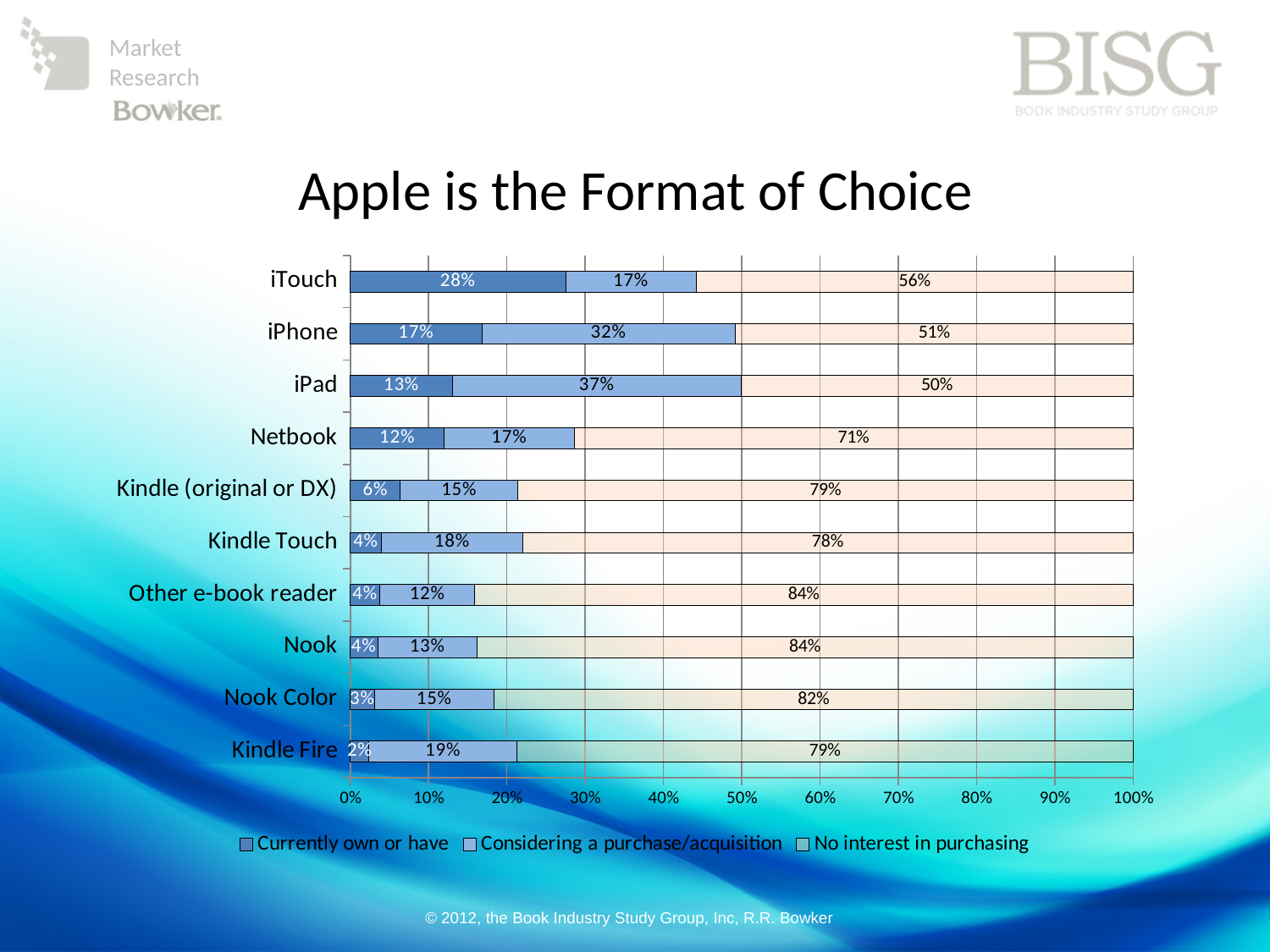
How many devices are listed on the chart? 10 What is the difference between the 'Considering a purchase/acquisition' percentages for the iPhone and the iTouch? 15% Which device has the lowest 'Currently own or have' percentage? Kindle Fire Which is larger: the 'No interest in purchasing' percentage for the Nook or for the Nook Color? Nook Which device has the highest 'Currently own or have' percentage? iTouch What is the title of the chart on the slide? Apple is the Format of Choice What percentage of respondents are considering a purchase/acquisition of an iPad? 37% What percentage of respondents currently own or have an iTouch? 28% What percentage of respondents have no interest in purchasing a Netbook? 71% What kind of chart is shown on the slide? Stacked bar chart How many series does the legend list? 3 Which device has the highest 'Considering a purchase/acquisition' percentage? iPad